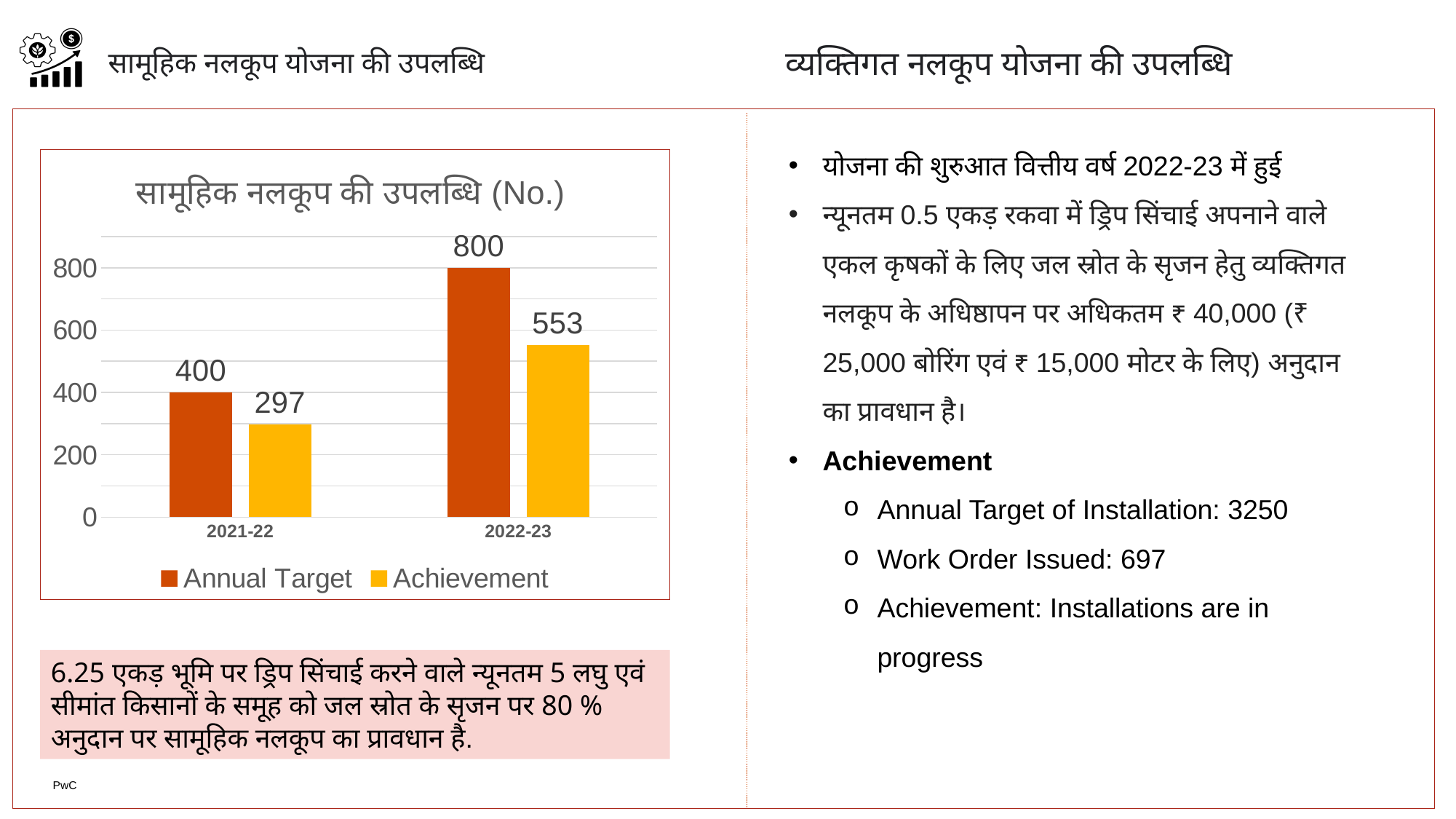
Which year has the highest Annual Target? 2022-23 Which is larger: the Achievement in 2022-23 or the Annual Target in 2021-22? Achievement in 2022-23 What is the difference between the Annual Target for 2022-23 and 2021-22? 400 Which year has the lowest Achievement? 2021-22 What is the Annual Target value for 2022-23? 800 What is the Achievement value for 2022-23? 553 What is the Annual Target value for 2021-22? 400 What type of chart is shown on the slide? Bar chart How many series does the chart legend list? 2 What is the difference between the Annual Target and Achievement in 2022-23? 247 How many years are shown on the x axis of the chart? 2 What is the Achievement value for 2021-22? 297